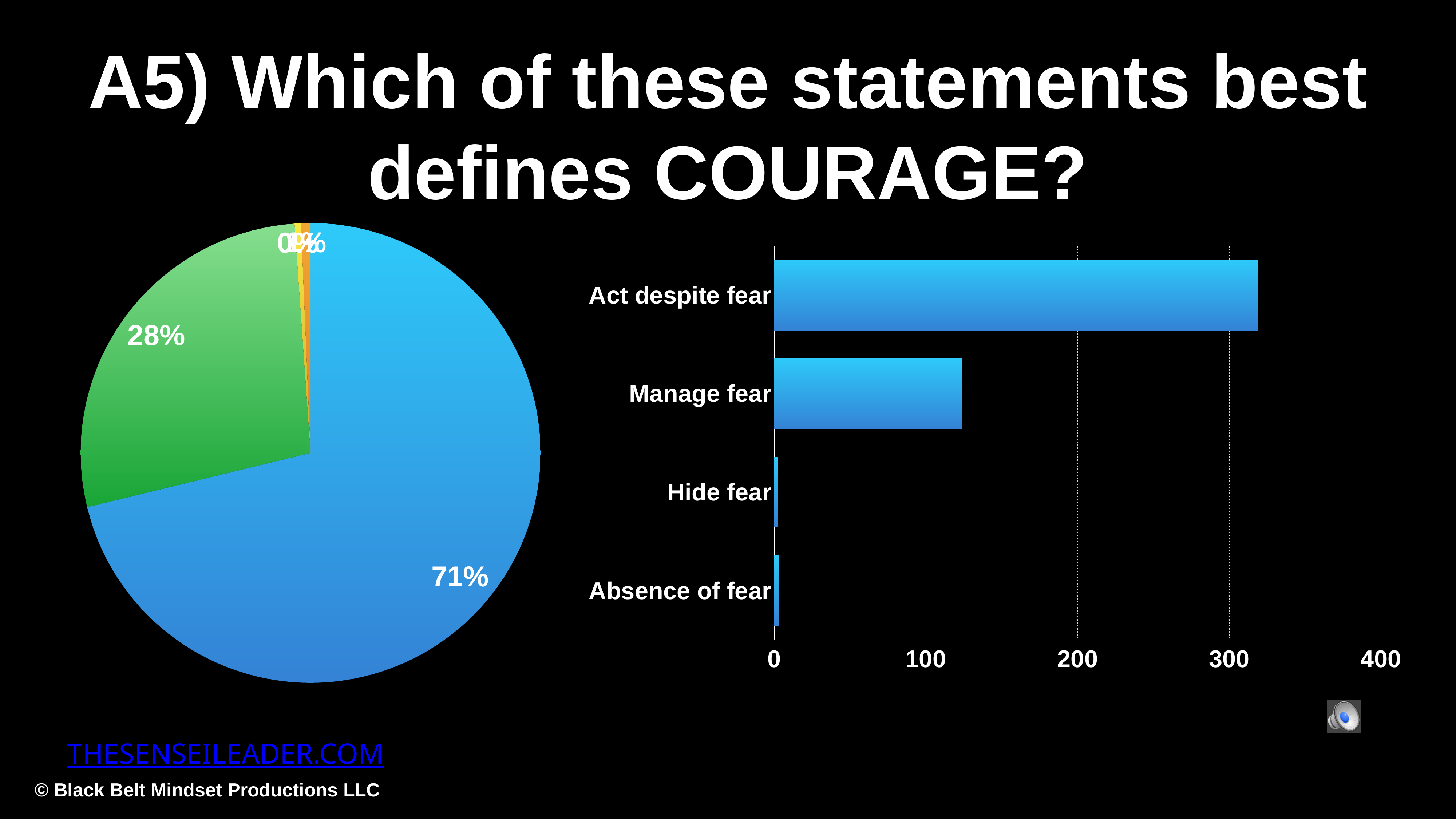
In the bar chart on the right, which category has the highest value? Act despite fear In the bar chart on the right, is the value for Act despite fear greater or less than 300? greater In the bar chart on the right, is the value for Hide fear greater or less than 100? less In the pie chart on the left, what share does the green slice have? 28% In the pie chart on the left, what is the difference between the 71% slice and the 28% slice? 43% In the bar chart on the right, is the value for Manage fear greater or less than 200? less In the bar chart on the right, which is larger: the value for Act despite fear or the value for Manage fear? Act despite fear In the pie chart on the left, what share does the largest slice have? 71% What kind of chart is the chart on the left of the slide? pie chart In the bar chart on the right, how many categories are shown? 4 What kind of chart is the chart on the right of the slide? bar chart